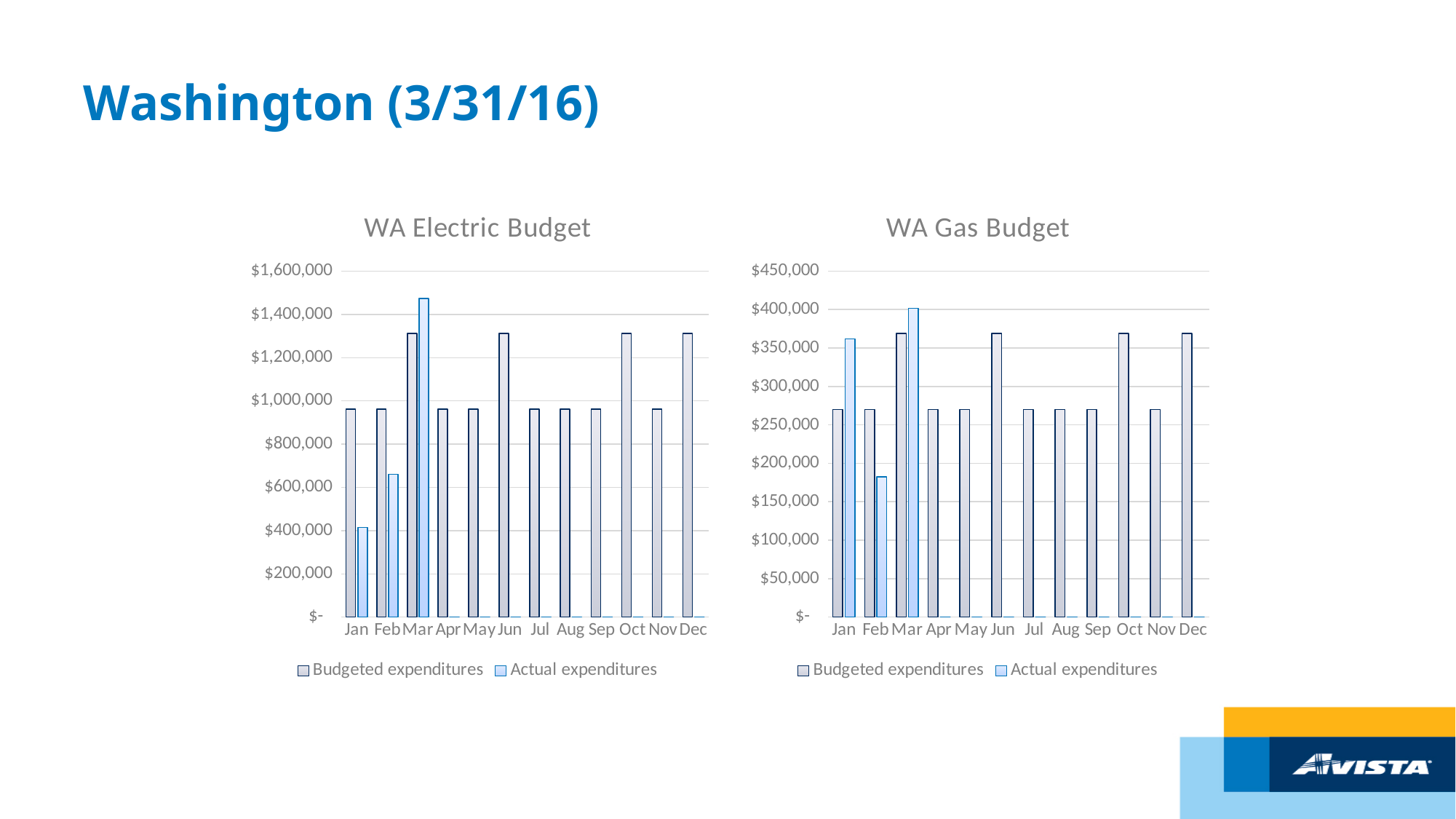
In the WA Electric Budget chart, which month has the highest Actual expenditures? Mar In the WA Electric Budget chart, which is larger: Budgeted expenditures for Mar or for Apr? Mar In the WA Gas Budget chart, which is larger for Jan: Budgeted expenditures or Actual expenditures? Actual expenditures In the WA Gas Budget chart, is the value for Actual expenditures in Mar greater or less than $350,000? greater How many months are shown on the x axis of the WA Electric Budget chart? 12 In the WA Electric Budget chart, is the value for Actual expenditures in Jan greater or less than $600,000? less In the WA Electric Budget chart, is the value for Actual expenditures in Mar greater or less than $1,400,000? greater How many series does the legend of the WA Gas Budget chart list? 2 What kind of chart is the WA Electric Budget chart? bar chart What are the two legend entries in the WA Electric Budget chart? Budgeted expenditures and Actual expenditures